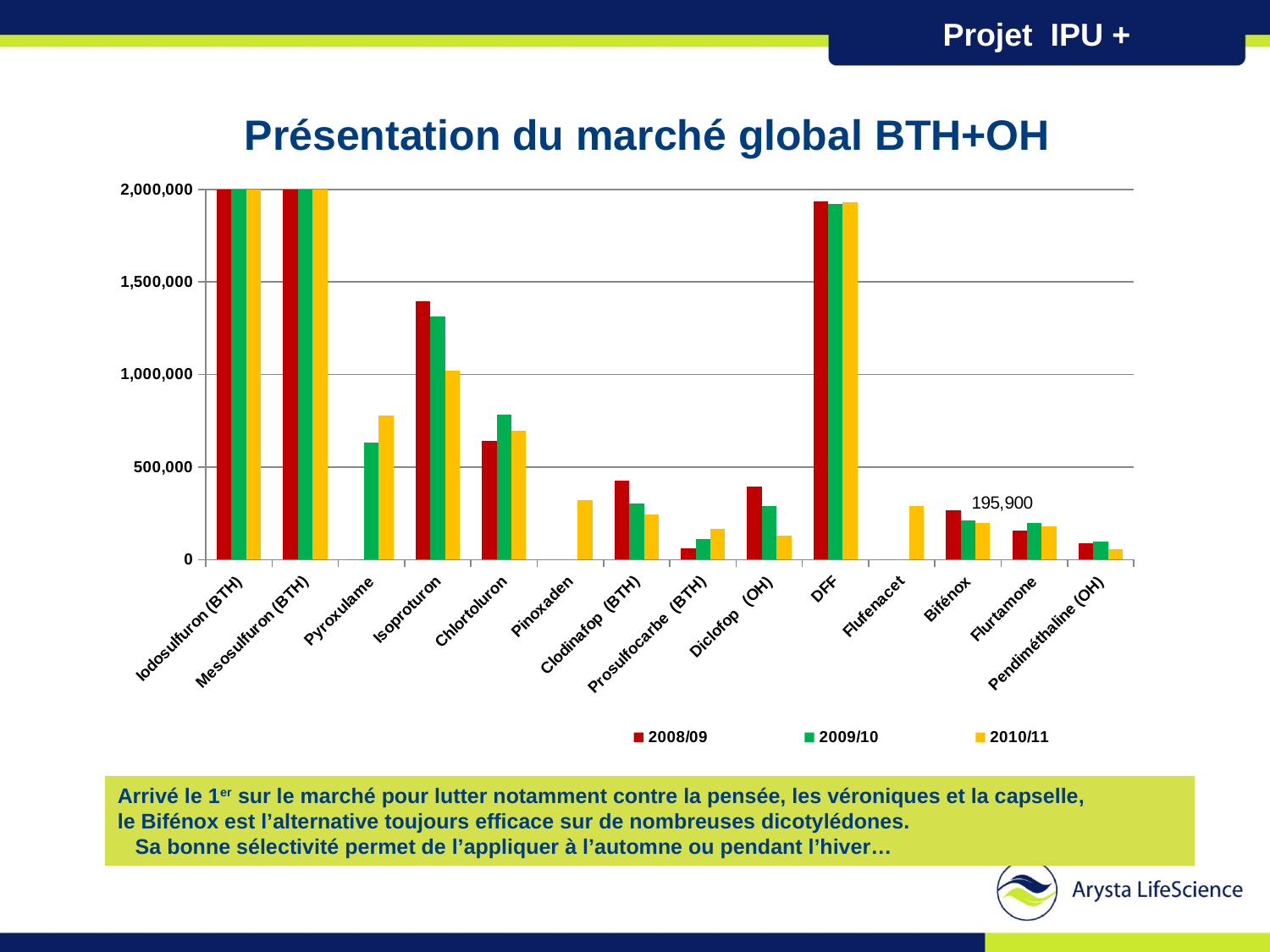
What kind of chart is shown on the slide? bar chart For Isoproturon, which is larger: the 2008/09 value or the 2010/11 value? 2008/09 Is the 2008/09 value for Isoproturon greater or less than 1,000,000? greater How many series does the legend list? 3 What is the title of the chart? Présentation du marché global BTH+OH For Diclofop (OH), do the values rise or fall from 2008/09 to 2010/11? fall Which series is shown in red in the legend? 2008/09 Is the 2008/09 value for Clodinafop (BTH) greater or less than 500,000? less Is the 2008/09 value for DFF greater or less than 1,500,000? greater How many product categories are shown on the x axis? 14 Which category has the data label 195,900 printed above its bars? Bifénox